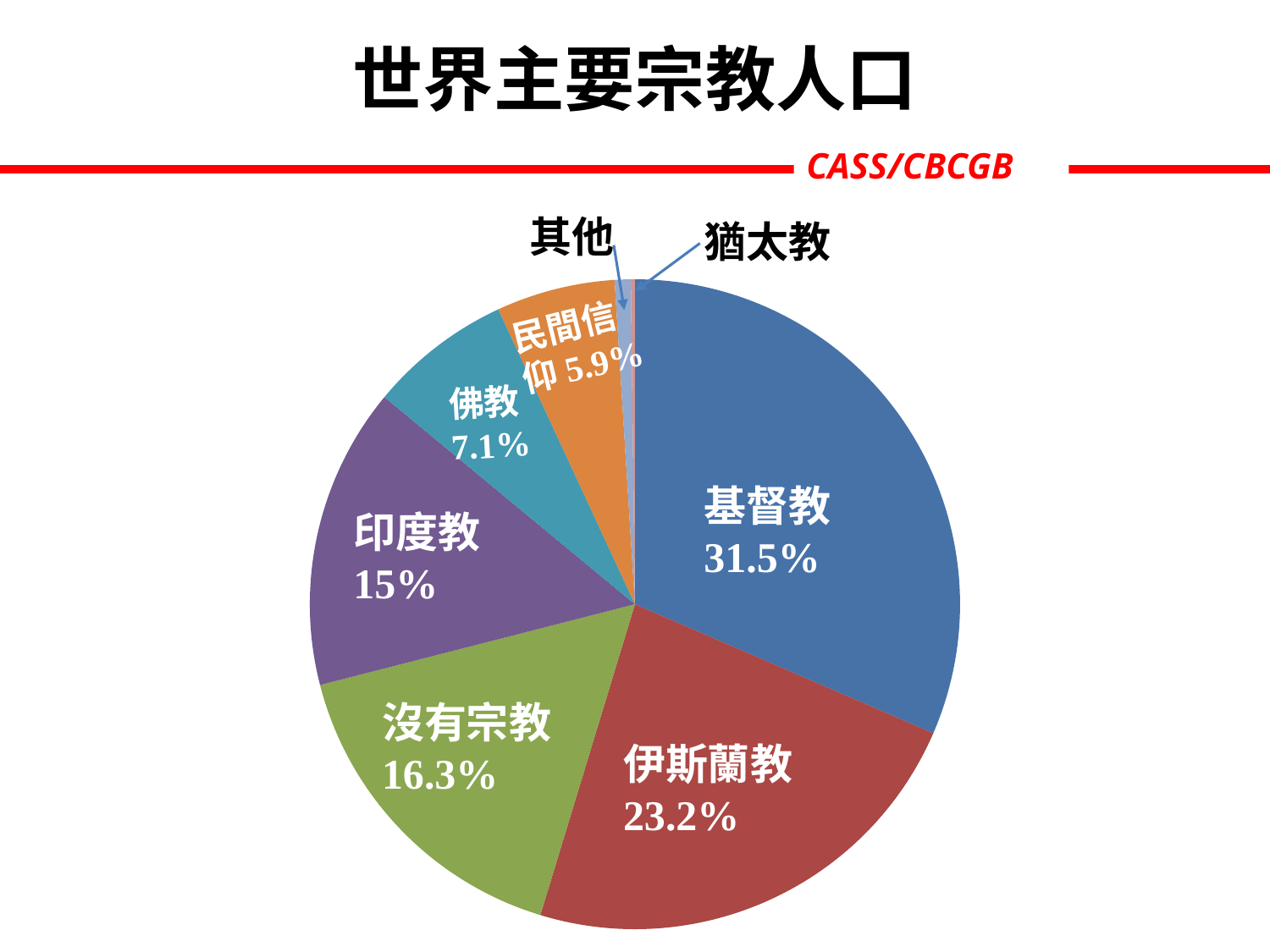
What percentage is shown for 伊斯蘭教? 23.2% What is the title of the chart? 世界主要宗教人口 What kind of chart is shown on the slide? pie chart What is the difference in percentage points between 基督教 and 伊斯蘭教? 8.3 What percentage is shown for 沒有宗教? 16.3% What percentage is shown for 民間信仰? 5.9% Which slice has the smallest printed percentage? 民間信仰 What percentage is shown for 印度教? 15% What percentage is shown for 佛教? 7.1% How many slices does the pie chart have? 8 Which slice of the pie is the largest? 基督教 What percentage is shown for 基督教? 31.5%